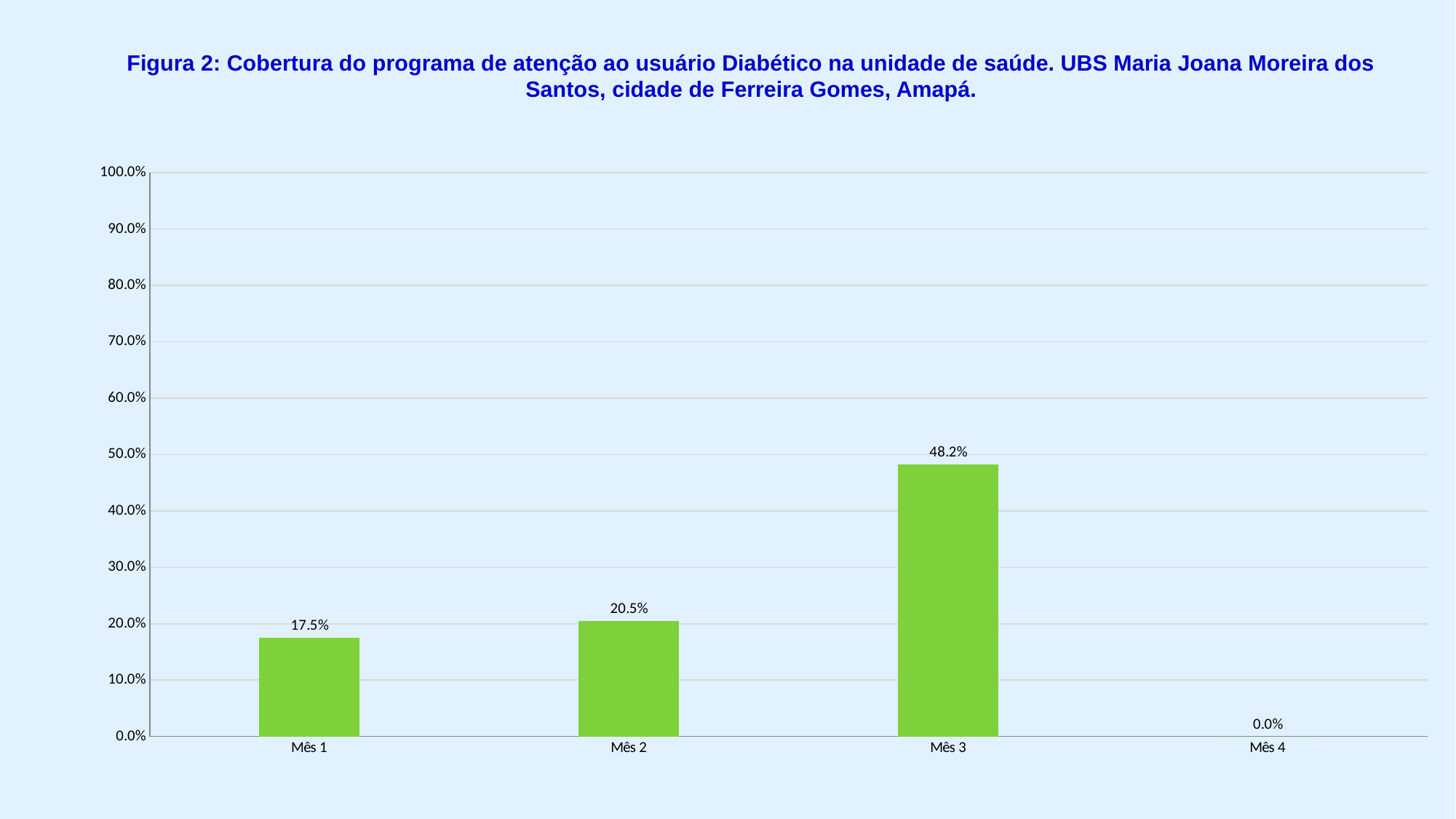
Which month has the highest value? Mês 3 What is the value for Mês 4? 0.0% What is the value for Mês 3? 48.2% What is the difference between the values for Mês 3 and Mês 2? 27.7% Is the value for Mês 3 greater or less than 50%? less What kind of chart is shown on the slide? Bar chart How many months are shown on the x axis? 4 Which is larger, the value for Mês 1 or the value for Mês 2? Mês 2 What is the difference between the values for Mês 2 and Mês 1? 3.0% What is the value for Mês 1? 17.5% What is the value for Mês 2? 20.5% Which month has the lowest value? Mês 4